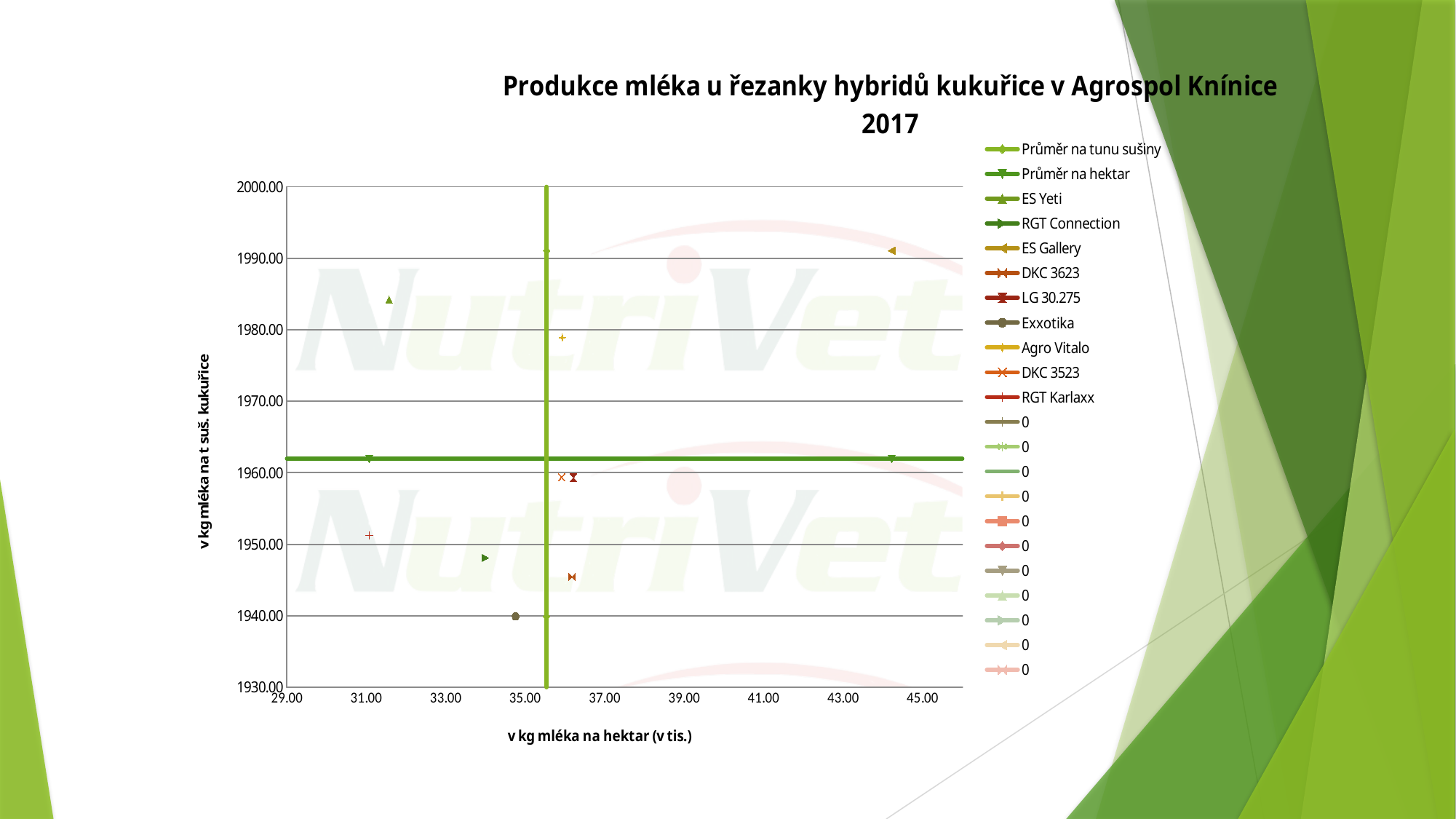
Which hybrid has the lowest value on the horizontal axis (kg mléka na hektar)? RGT Karlaxx Which hybrid has the lowest value on the vertical axis (kg mléka na t suš. kukuřice)? Exxotika What kind of chart is shown on the slide? scatter chart What is the label of the horizontal axis of the chart? v kg mléka na hektar (v tis.) Which hybrid has the highest value on the horizontal axis (kg mléka na hektar)? ES Gallery Is the vertical-axis value for DKC 3623 greater or less than 1950.00? less Which has the higher vertical-axis value, ES Yeti or RGT Connection? ES Yeti Is the vertical-axis value for ES Yeti greater or less than 1980.00? greater What is the title of the chart? Produkce mléka u řezanky hybridů kukuřice v Agrospol Knínice 2017 Which hybrid has the highest value on the vertical axis (kg mléka na t suš. kukuřice)? ES Gallery Which has the larger horizontal-axis value, Exxotika or ES Gallery? ES Gallery Is the vertical-axis value for RGT Connection greater or less than 1950.00? less